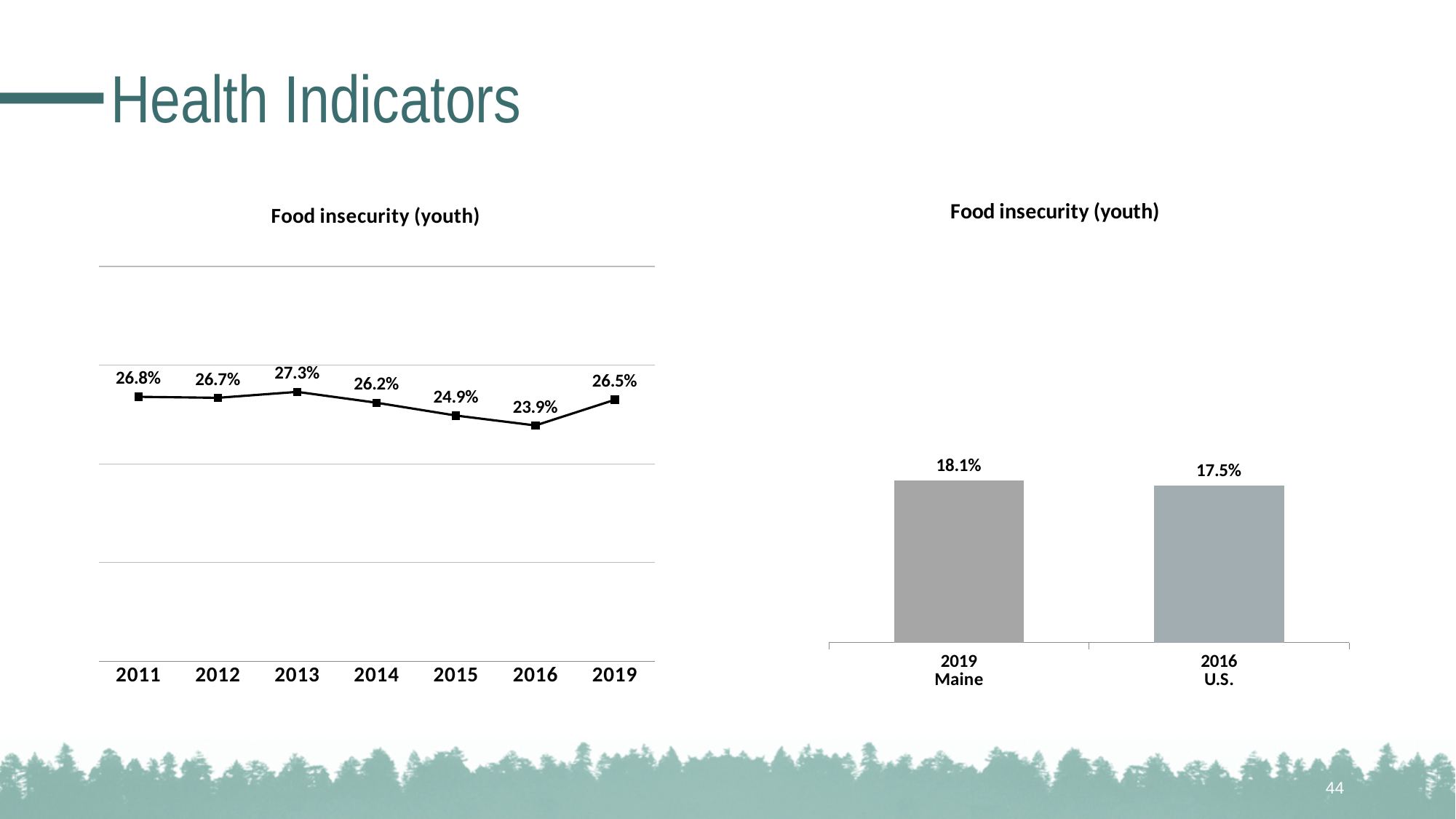
In the left chart (Food insecurity (youth) line chart), which year has the lowest value? 2016 In the right chart (Food insecurity (youth) bar chart), what is the difference between the Maine value and the U.S. value? 0.6% In the left chart (Food insecurity (youth) line chart), what is the difference between the 2013 value and the 2016 value? 3.4% In the left chart (Food insecurity (youth) line chart), how many years are plotted? 7 In the left chart (Food insecurity (youth) line chart), what is the value for 2016? 23.9% In the left chart (Food insecurity (youth) line chart), which year has the highest value? 2013 In the left chart (Food insecurity (youth) line chart), what is the value for 2013? 27.3% In the right chart (Food insecurity (youth) bar chart), what is the value for 2019 Maine? 18.1% What kind of chart is the left chart on the slide? Line chart What kind of chart is the right chart on the slide? Bar chart In the left chart (Food insecurity (youth) line chart), does the value rise or fall from 2013 to 2016? Fall In the right chart (Food insecurity (youth) bar chart), what is the value for 2016 U.S.? 17.5%